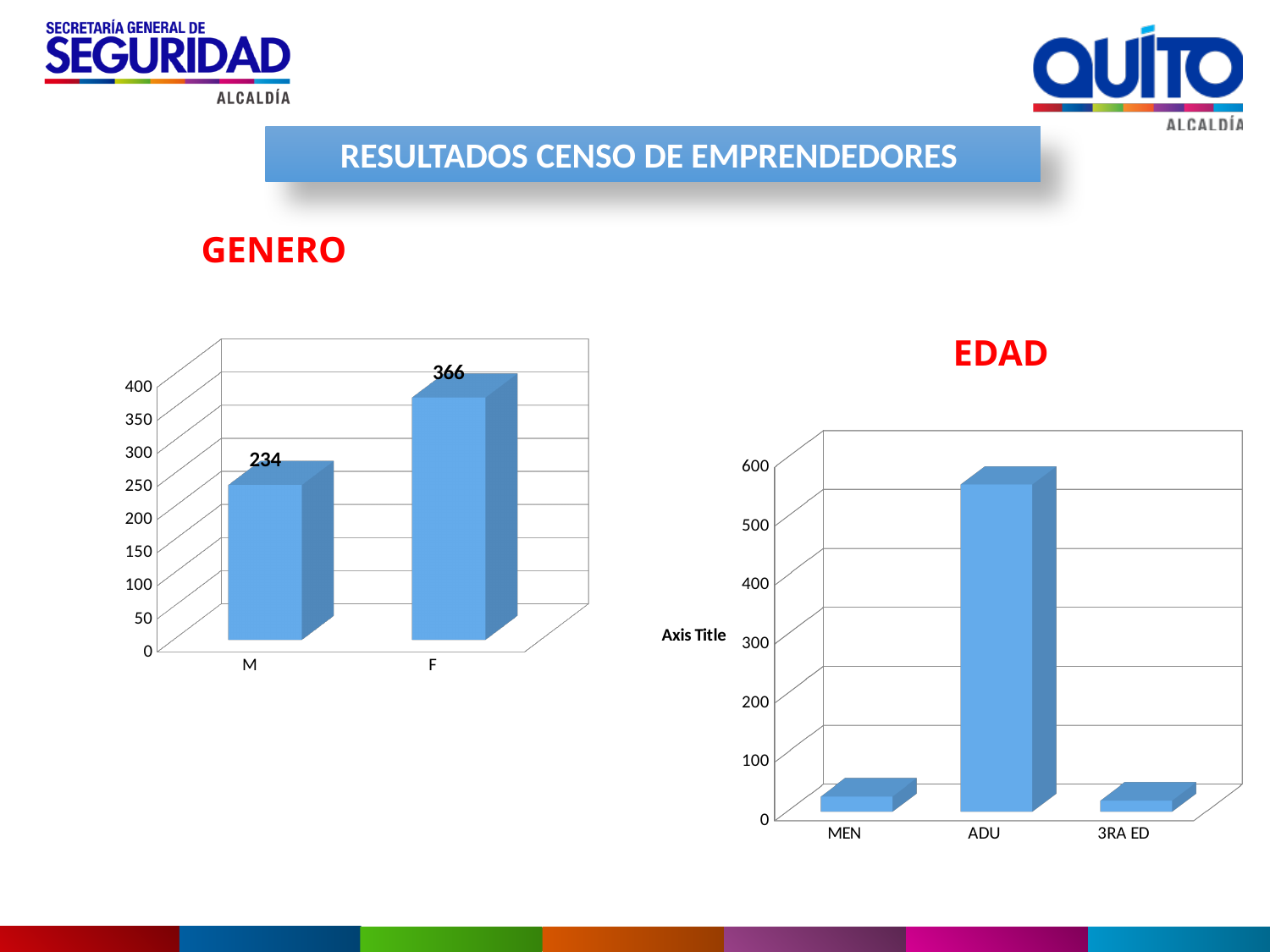
In the EDAD chart, how many categories are shown on the x axis? 3 In the GENERO chart, what is the value for M? 234 In the GENERO chart, how many categories are shown? 2 In the EDAD chart, which category has the highest value? ADU In the EDAD chart, is the value for ADU greater or less than 500? greater In the EDAD chart, is the value for MEN greater or less than 100? less What kind of chart is the GENERO chart? bar chart In the GENERO chart, which category has the lowest value? M In the GENERO chart, what is the difference between the values for F and M? 132 In the GENERO chart, which category has the highest value? F In the GENERO chart, what is the value for F? 366 In the EDAD chart, which is larger, the value for ADU or the value for 3RA ED? ADU